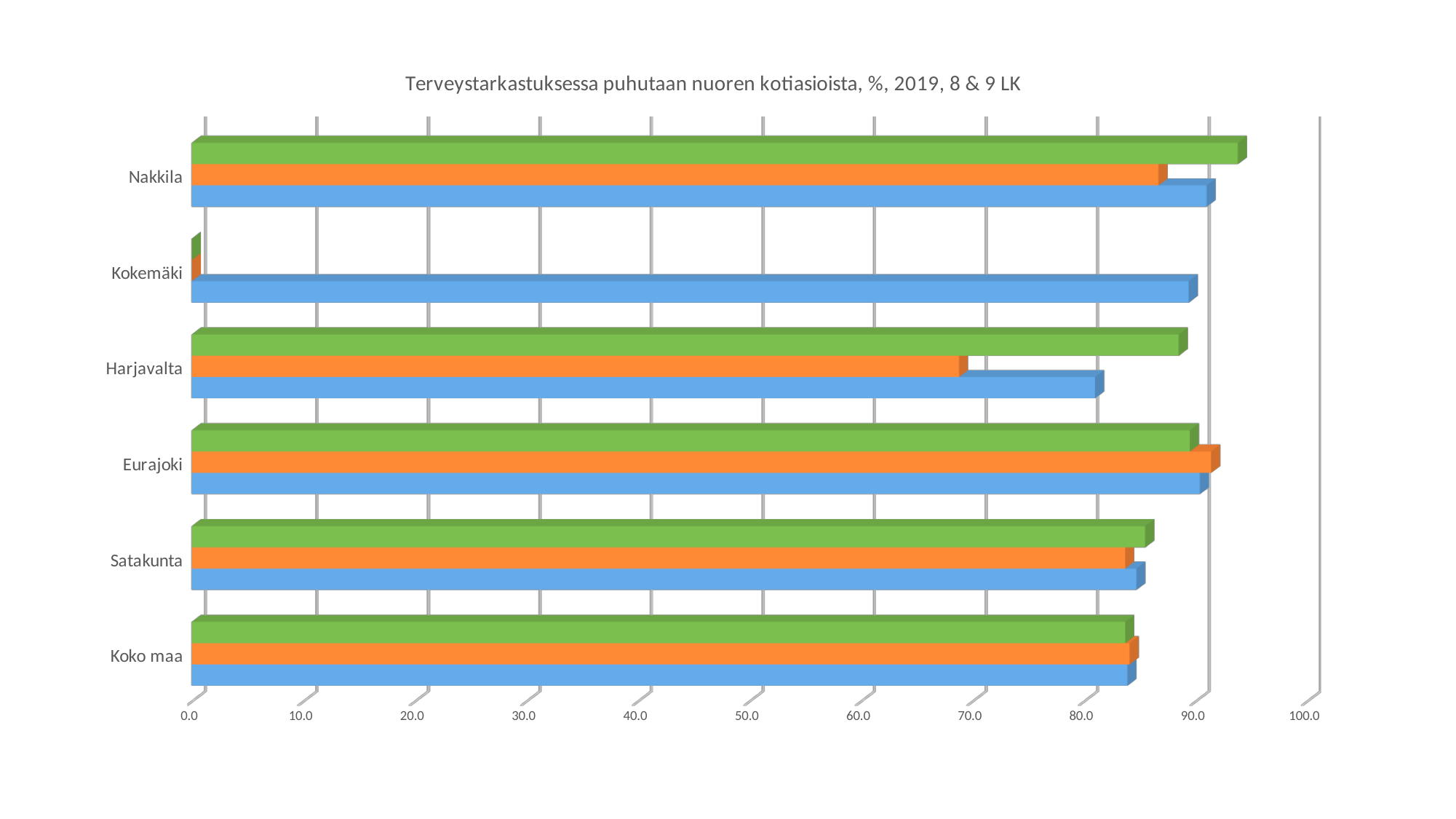
For Harjavalta, which is larger: the green bar or the orange bar? the green bar What kind of chart is shown on the slide? bar chart Which category has the shortest blue bar? Harjavalta For Nakkila, which is larger: the blue bar or the orange bar? the blue bar How many bars are drawn for each category in the chart? 3 Is the orange bar for Harjavalta greater or less than 70? less How many categories are shown on the vertical axis of the chart? 6 Is the green bar for Nakkila greater or less than 90? greater Which category has the longest green bar? Nakkila What is the title of the chart? Terveystarkastuksessa puhutaan nuoren kotiasioista, %, 2019, 8 & 9 LK Which category has the shortest orange bar? Kokemäki